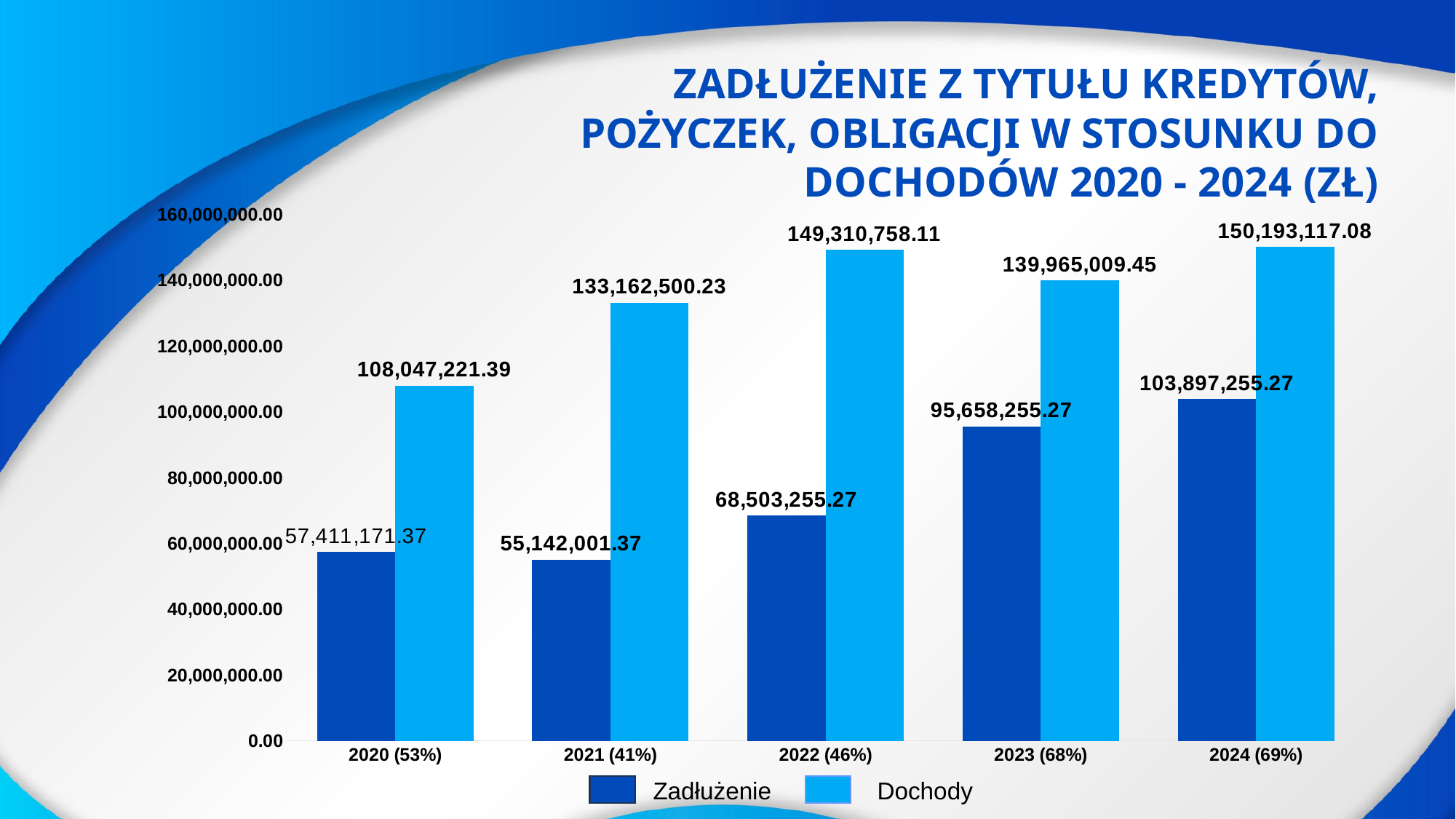
What is the Zadłużenie value for 2024 (69%)? 103,897,255.27 What is the Zadłużenie value for 2020 (53%)? 57,411,171.37 How many year categories are shown on the x axis? 5 Which is larger: Dochody in 2021 (41%) or Dochody in 2023 (68%)? Dochody in 2023 (68%) Which year has the lowest Zadłużenie value? 2021 (41%) Does the Zadłużenie value rise or fall from 2021 (41%) to 2024 (69%)? rise What type of chart is shown on the slide? bar chart How many series does the legend list? 2 What is the Dochody value for 2022 (46%)? 149,310,758.11 Which year has the highest Dochody value? 2024 (69%) Which series is shown in the darker blue colour? Zadłużenie What is the difference between Dochody and Zadłużenie in 2024 (69%)? 46,295,861.81